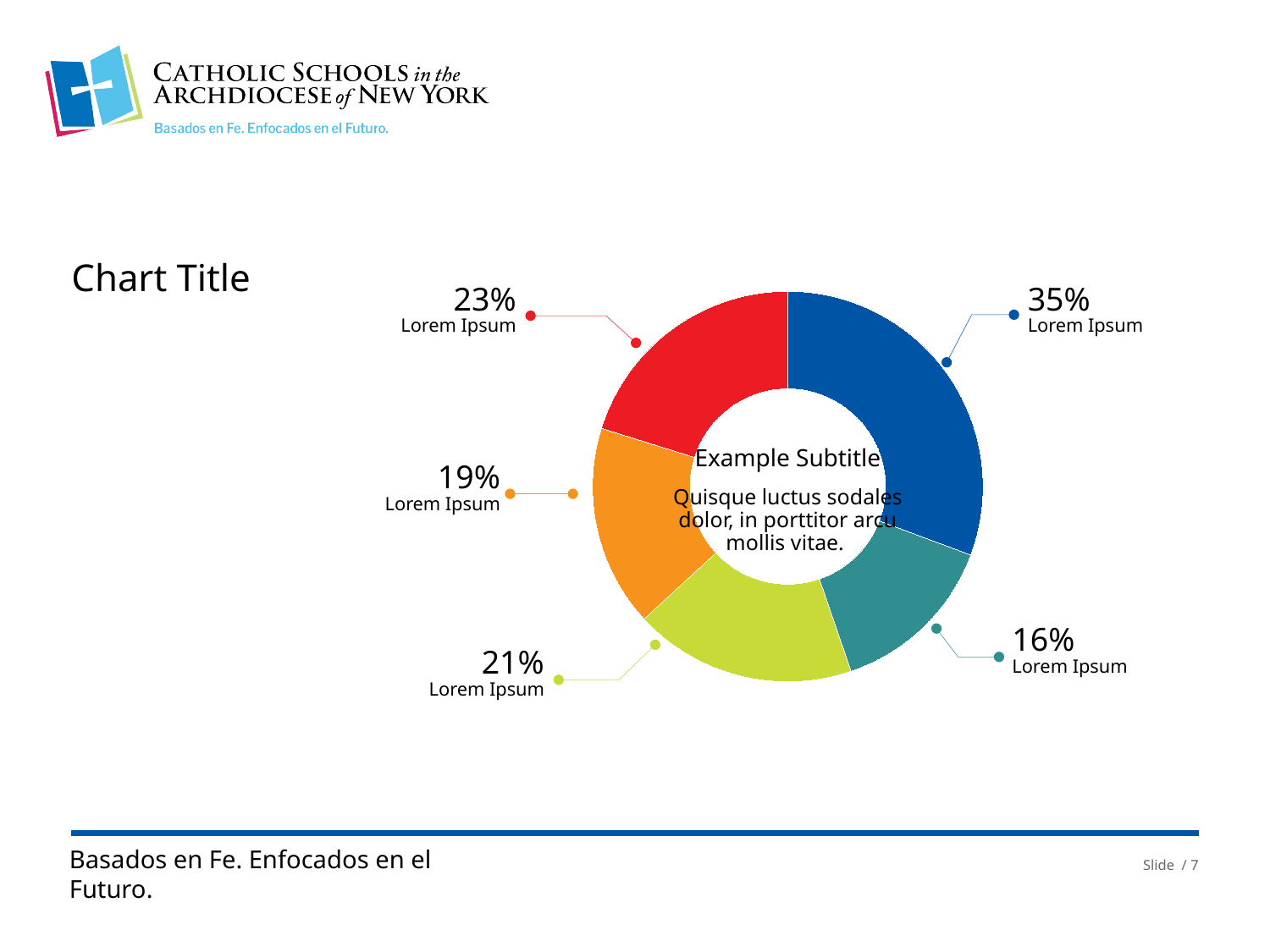
What is the title of the chart? Chart Title What is the value of the dark blue slice of the donut chart? 35% How many slices does the donut chart have? 5 What is the difference between the largest slice (35%) and the smallest slice (16%)? 19% What kind of chart is shown on the slide? Pie chart (donut) What is the value of the red slice of the donut chart? 23% Which slice of the donut chart has the smallest share? The teal slice (16%) Which is larger, the red slice or the lime green slice? The red slice (23%) What is the value of the lime green slice of the donut chart? 21% Which slice of the donut chart has the largest share? The dark blue slice (35%) What is the value of the teal slice of the donut chart? 16% What is the value of the orange slice of the donut chart? 19%